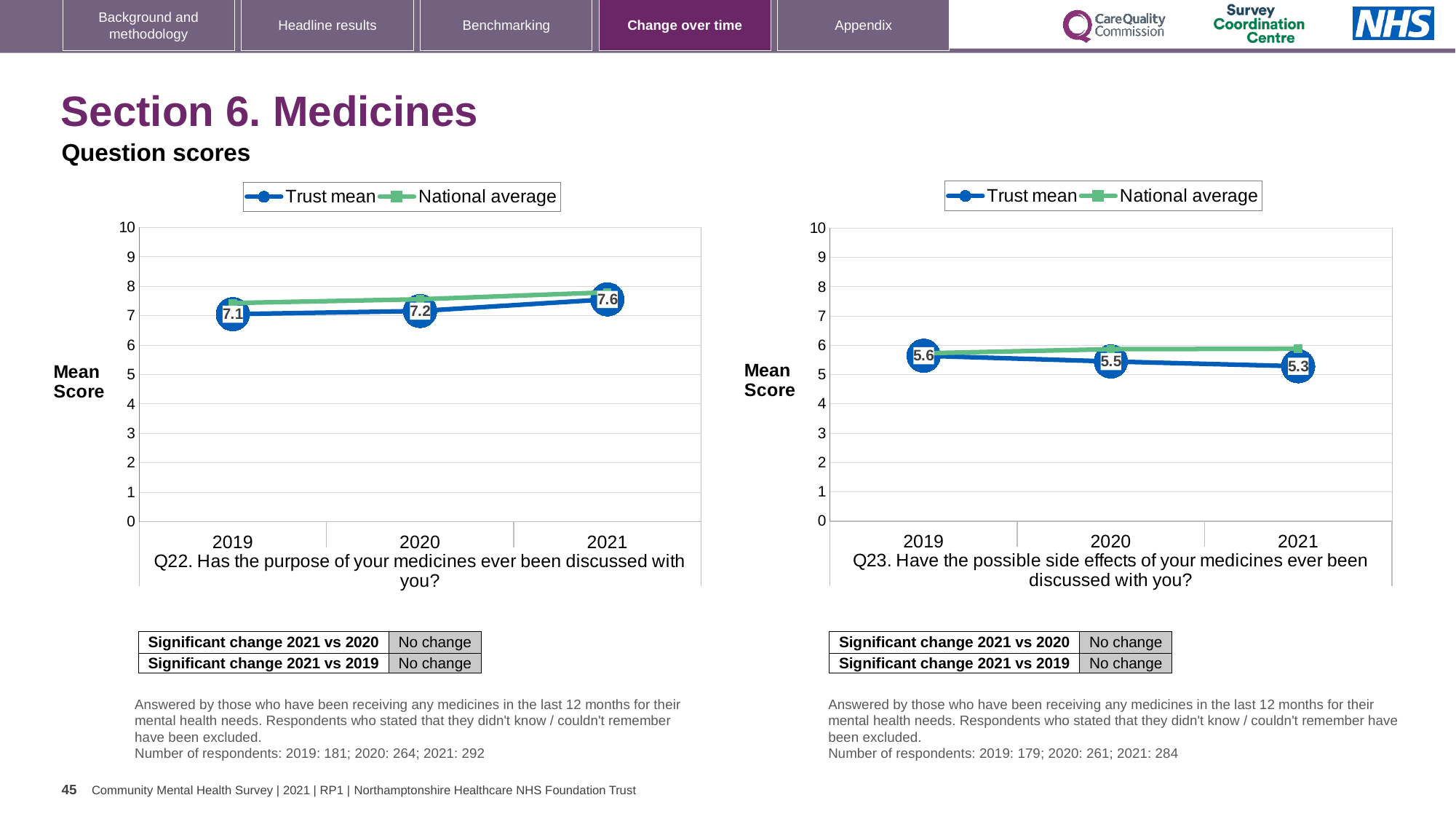
In the Q23 chart on the right, what is the Trust mean for 2021? 5.3 In the Q22 chart on the left, what is the Trust mean for 2019? 7.1 In the Q22 chart on the left, what is the difference between the Trust mean in 2021 and in 2019? 0.5 In the Q23 chart on the right, does the Trust mean rise or fall from 2019 to 2021? Fall How many series does the legend of the Q22 chart on the left list? 2 In the Q22 chart on the left, which year has the highest Trust mean? 2021 In the Q23 chart on the right, which year has the lowest Trust mean? 2021 In the Q23 chart on the right, is the Trust mean higher in 2019 or in 2021? 2019 In the Q23 chart on the right, what is the Trust mean for 2020? 5.5 What kind of chart is the Q23 chart on the right? Line chart In the Q23 chart on the right, is the National average for 2021 greater or less than 5? greater In the Q22 chart on the left, what is the Trust mean for 2021? 7.6